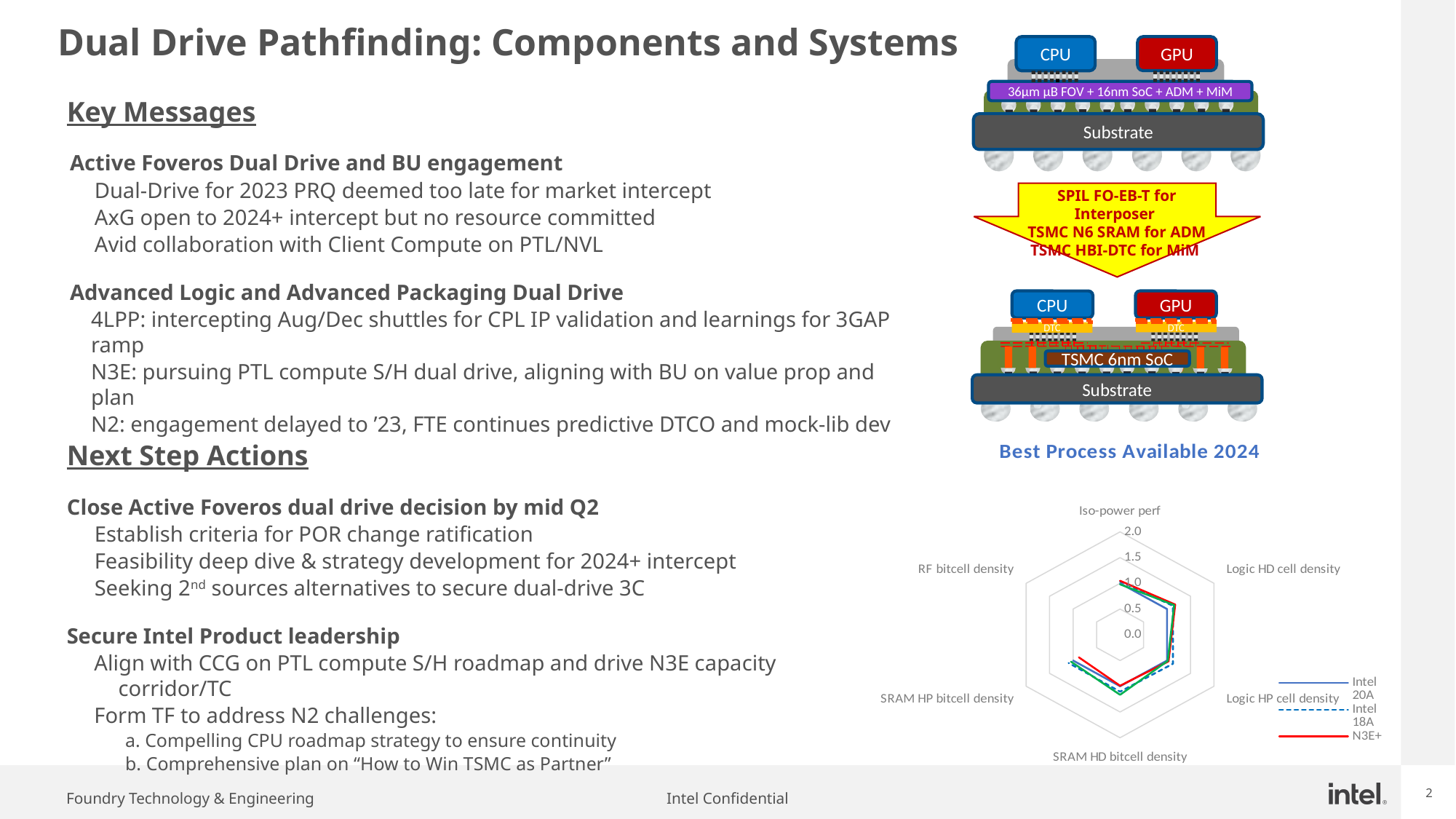
In the radar chart, is the value for Iso-power perf for Intel 18A greater or less than 2.0? less How many series does the legend of the radar chart list? 3 Which series are listed in the legend of the radar chart? Intel 20A, Intel 18A, N3E+ Which category is at the top of the radar chart? Iso-power perf Which category is at the bottom of the radar chart? SRAM HD bitcell density How many axes (categories) does the radar chart have? 6 What kind of chart is shown at the bottom right of the slide? Radar chart In the radar chart, which series is drawn with a red line? N3E+ What is the maximum value shown on the radar chart's scale? 2.0 In the radar chart, is the value for Logic HP cell density for N3E+ greater or less than 1.5? less